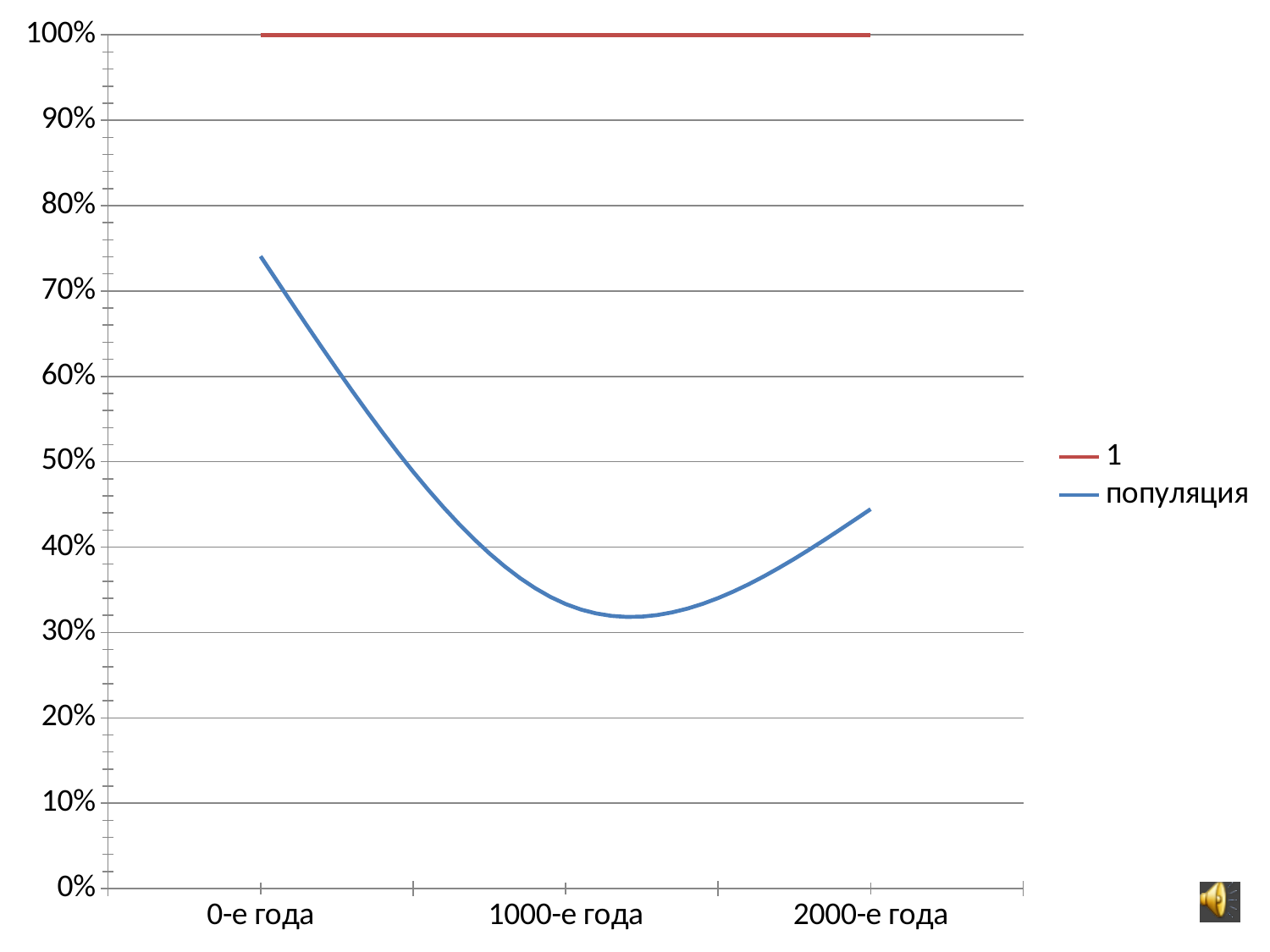
What kind of chart is shown on the slide? line chart What colour is the line for the популяция series? blue At which category is the популяция series highest? 0-е года Is the value for популяция at 0-е года greater or less than 70%? greater At which category is the популяция series lowest? 1000-е года Is the value for популяция at 2000-е года greater or less than 50%? less How many categories are shown on the x axis? 3 What is the value of the series "1" at 0-е года? 100% For the популяция series, which is larger: the value at 0-е года or at 2000-е года? 0-е года Is the value for популяция at 1000-е года greater or less than 40%? less Does the популяция series rise or fall from 0-е года to 1000-е года? fall How many series does the legend list? 2